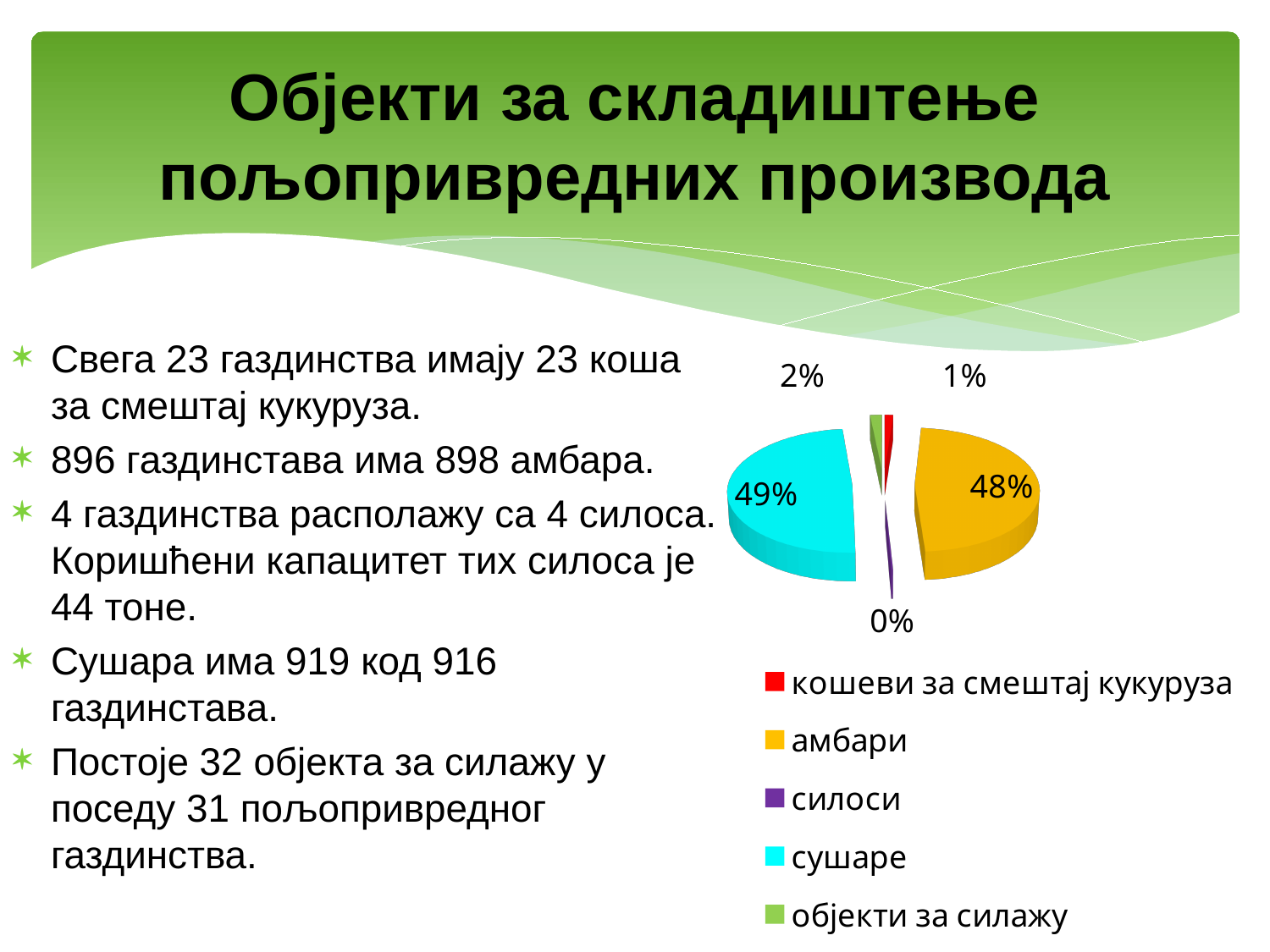
What is the difference in percentage points between the slices for сушаре and амбари? 1% What share of the pie does the slice for силоси represent? 0% What kind of chart is shown on the slide? pie chart Which category has the largest slice of the pie? сушаре What share of the pie does the slice for кошеви за смештај кукуруза represent? 1% What share of the pie does the slice for објекти за силажу represent? 2% Which slice is larger, објекти за силажу or кошеви за смештај кукуруза? објекти за силажу Which category has the smallest slice of the pie? силоси How many categories does the pie chart legend list? 5 What colour is the slice for амбари? yellow